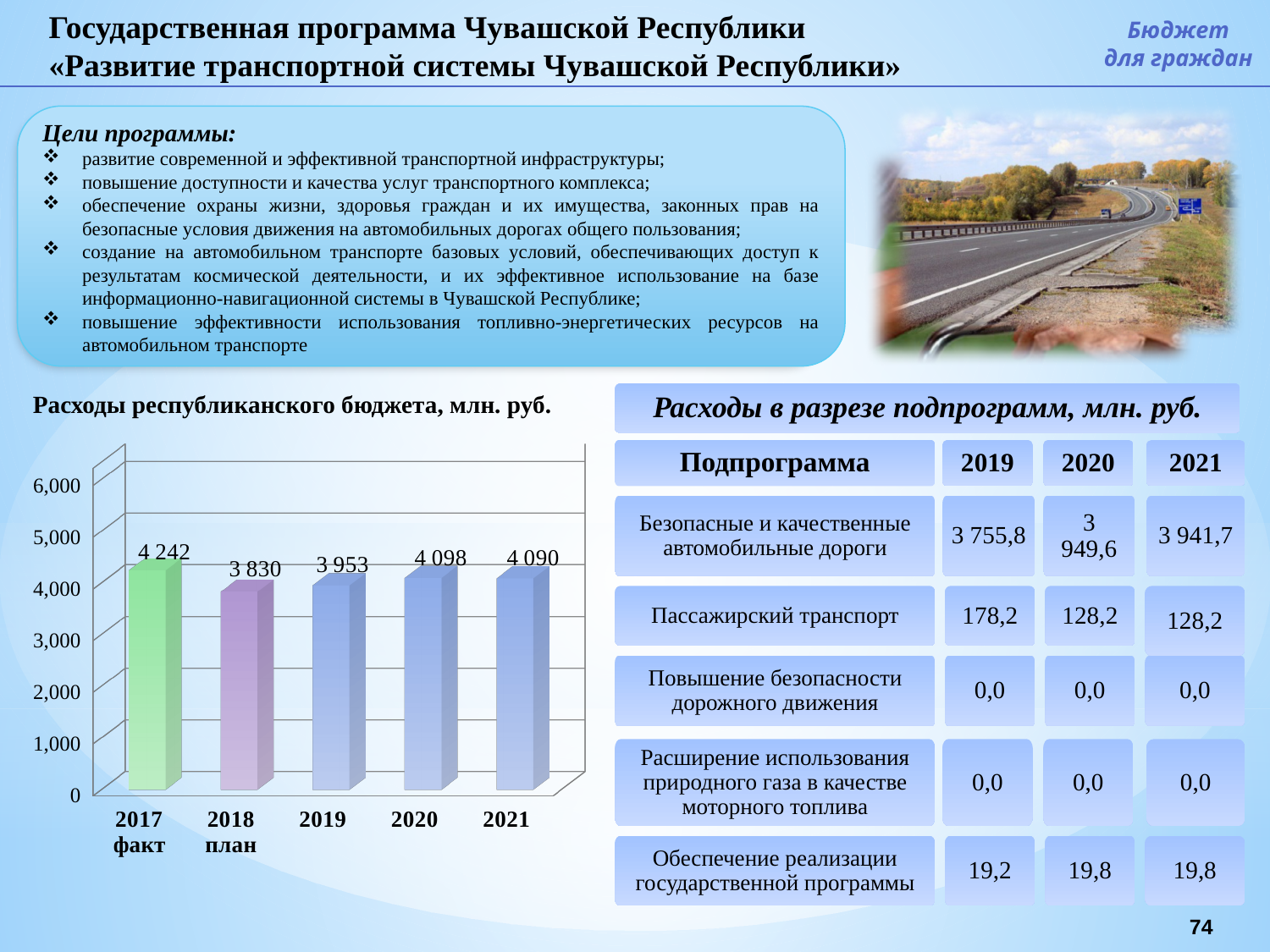
What is the difference between the values for 2017 факт and 2018 план in the chart 'Расходы республиканского бюджета, млн. руб.'? 412 What kind of chart is 'Расходы республиканского бюджета, млн. руб.'? bar chart What is the value for 2020 in the chart 'Расходы республиканского бюджета, млн. руб.'? 4 098 What is the title of the chart on the left side of the slide? Расходы республиканского бюджета, млн. руб. What is the difference between the values for 2020 and 2019 in the chart 'Расходы республиканского бюджета, млн. руб.'? 145 Which year has the lowest value in the chart 'Расходы республиканского бюджета, млн. руб.'? 2018 план What is the value for 2018 план in the chart 'Расходы республиканского бюджета, млн. руб.'? 3 830 What is the value for 2017 факт in the chart 'Расходы республиканского бюджета, млн. руб.'? 4 242 Which year has the highest value in the chart 'Расходы республиканского бюджета, млн. руб.'? 2017 факт How many bars are shown in the chart 'Расходы республиканского бюджета, млн. руб.'? 5 Which is larger in the chart 'Расходы республиканского бюджета, млн. руб.': the value for 2019 or the value for 2018 план? 2019 Is the value for 2021 in the chart 'Расходы республиканского бюджета, млн. руб.' greater or less than 4,000? greater